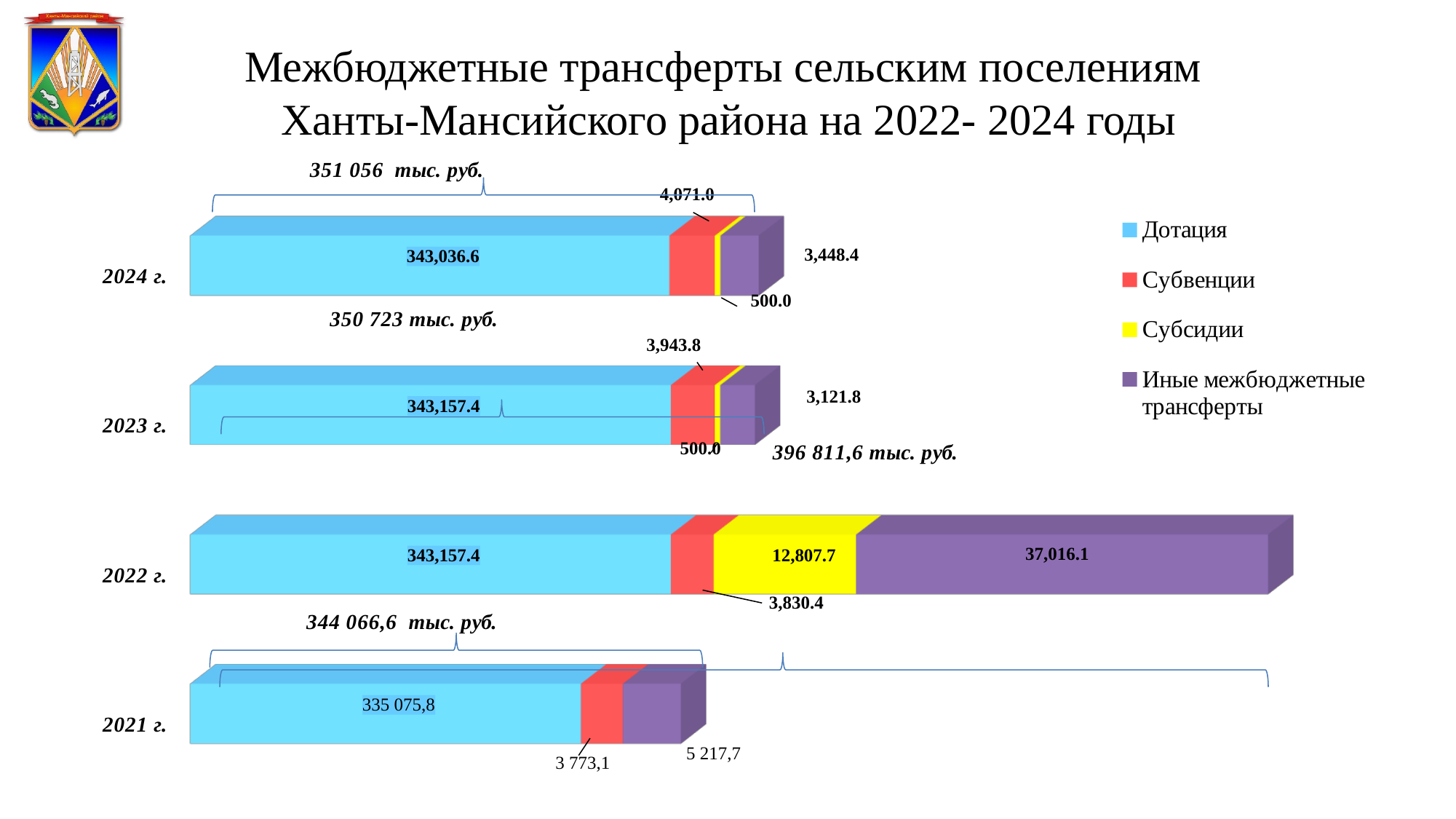
What is the total of the stacked bar for 2022 г. as labelled on the slide? 396 811,6 тыс. руб. Which is larger: Субсидии for 2022 г. or Субсидии for 2023 г.? Субсидии for 2022 г. How many series does the legend list? 4 What is the value of Дотация for 2024 г.? 343,036.6 Which year has the lowest value for Дотация? 2021 г. What kind of chart is shown on the slide? Stacked bar chart What is the value of Субвенции for 2021 г.? 3 773,1 What is the value of Субсидии for 2022 г.? 12,807.7 What is the difference between the Субвенции values for 2024 г. and 2023 г.? 127.2 Which year has the highest value for Иные межбюджетные трансферты? 2022 г. What is the value of Иные межбюджетные трансферты for 2022 г.? 37,016.1 How many years are shown on the chart? 4